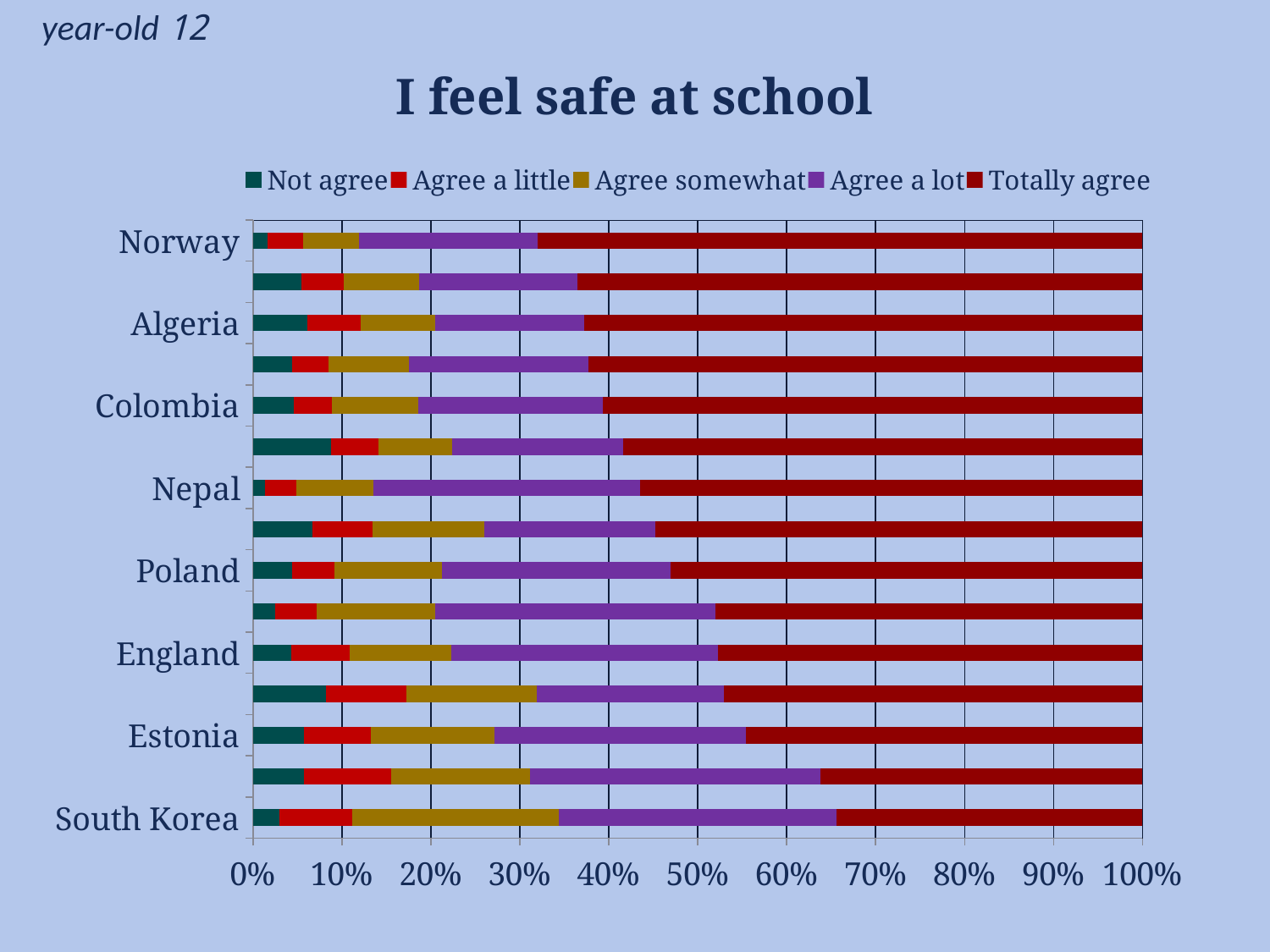
Which series is shown in dark red in the legend? Totally agree Is the 'Totally agree' share for Norway greater or less than 60%? greater How many country labels are shown on the vertical axis? 8 Which country has the larger 'Totally agree' share, Norway or South Korea? Norway Does the 'Totally agree' share rise or fall going down the chart from Norway to South Korea? fall Is the 'Totally agree' share for South Korea greater or less than 40%? less Among the labelled countries, which has the smallest 'Totally agree' share? South Korea Among the labelled countries, which has the largest 'Totally agree' share? Norway What is the title of the chart? I feel safe at school How many series does the legend list? 5 Is the 'Not agree' share for Norway greater or less than 10%? less What kind of chart is shown on the slide? stacked bar chart